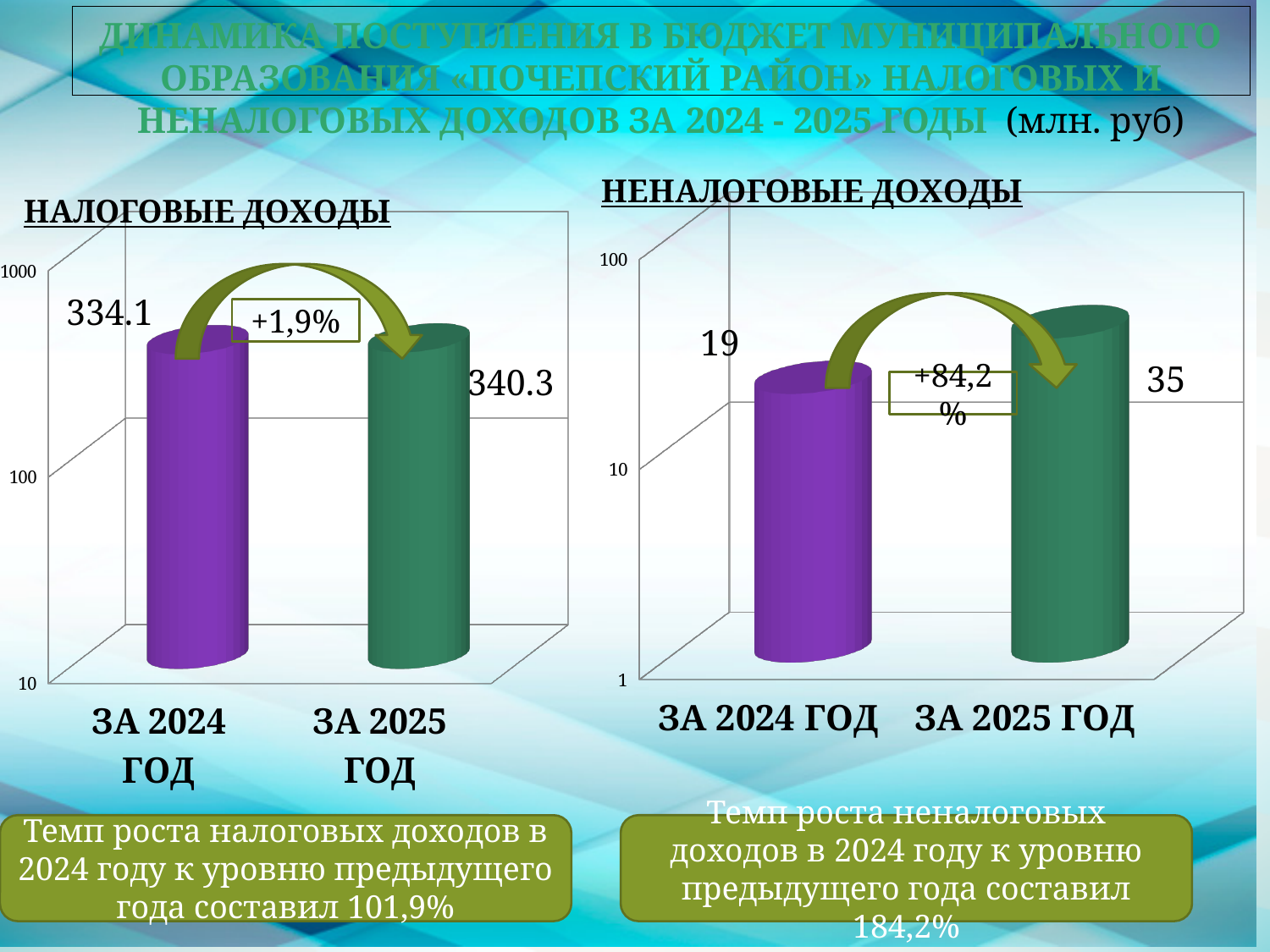
In the НЕНАЛОГОВЫЕ ДОХОДЫ chart, what is the value for ЗА 2025 ГОД? 35 How many categories are shown in the НАЛОГОВЫЕ ДОХОДЫ chart? 2 In the НАЛОГОВЫЕ ДОХОДЫ chart, what is the value for ЗА 2024 ГОД? 334.1 In the НАЛОГОВЫЕ ДОХОДЫ chart, what is the value for ЗА 2025 ГОД? 340.3 In the НАЛОГОВЫЕ ДОХОДЫ chart, what percentage change is shown in the label on the arrow between the two bars? +1,9% In the НЕНАЛОГОВЫЕ ДОХОДЫ chart, which year has the higher value? ЗА 2025 ГОД In the НАЛОГОВЫЕ ДОХОДЫ chart, what is the difference between the values for ЗА 2025 ГОД and ЗА 2024 ГОД? 6.2 In the НЕНАЛОГОВЫЕ ДОХОДЫ chart, what is the value for ЗА 2024 ГОД? 19 In the НАЛОГОВЫЕ ДОХОДЫ chart, which year has the lower value? ЗА 2024 ГОД In the НЕНАЛОГОВЫЕ ДОХОДЫ chart, what is the difference between the values for ЗА 2025 ГОД and ЗА 2024 ГОД? 16 What kind of chart is the НЕНАЛОГОВЫЕ ДОХОДЫ chart? bar chart In the НЕНАЛОГОВЫЕ ДОХОДЫ chart, is the value for ЗА 2024 ГОД greater or less than 10? greater